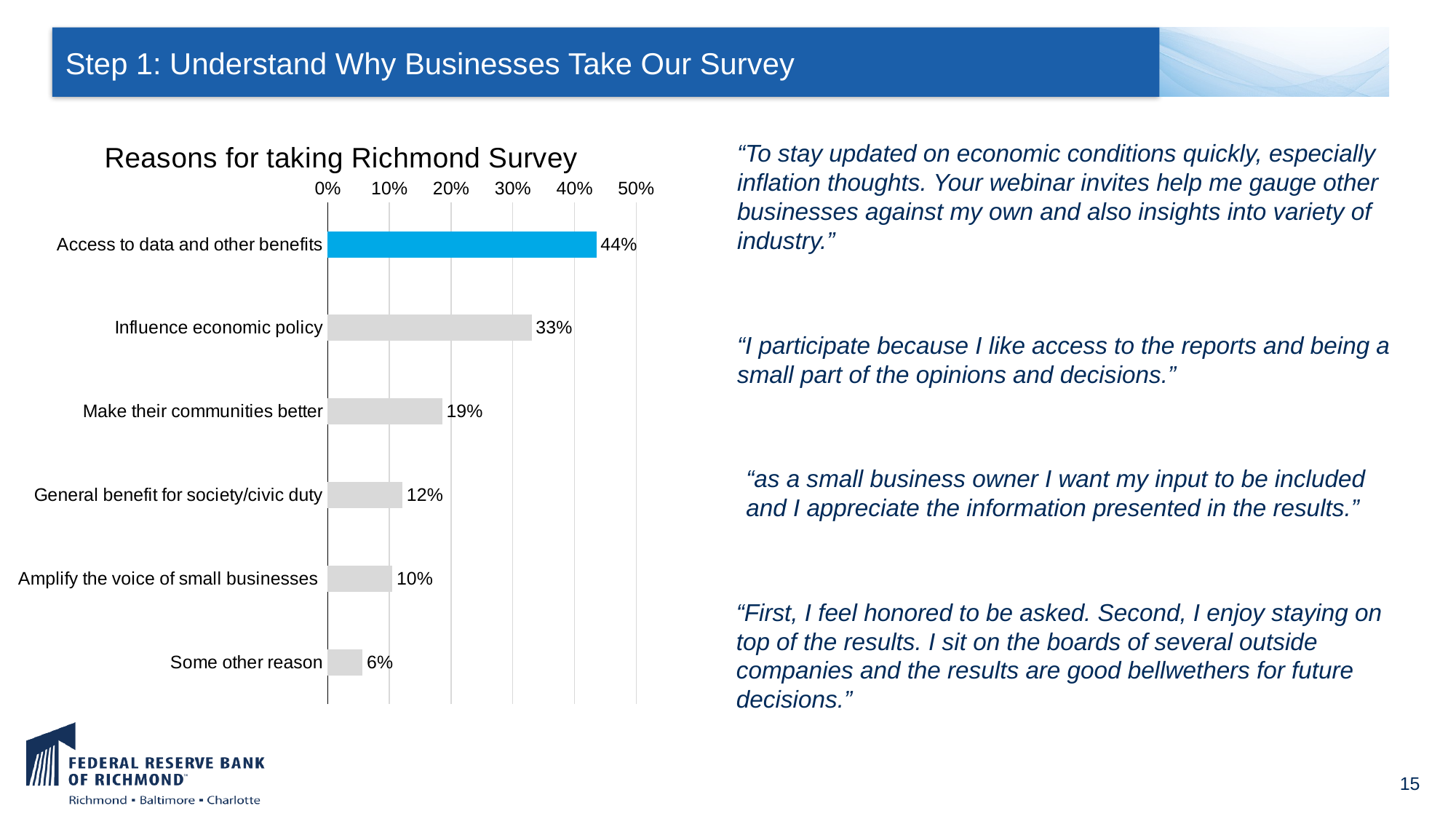
Which reason has the lowest value? Some other reason What is the value for "Influence economic policy"? 33% What kind of chart is shown on the slide? Bar chart What is the value for "Access to data and other benefits"? 44% What is the value for "Make their communities better"? 19% How many reasons (categories) are shown in the chart? 6 What is the difference between the values for "Access to data and other benefits" and "Influence economic policy"? 11% What is the title of the chart? Reasons for taking Richmond Survey Which reason has the highest value? Access to data and other benefits What is the difference between the values for "General benefit for society/civic duty" and "Some other reason"? 6% Which is larger, the value for "Make their communities better" or the value for "General benefit for society/civic duty"? Make their communities better What is the value for "Amplify the voice of small businesses"? 10%